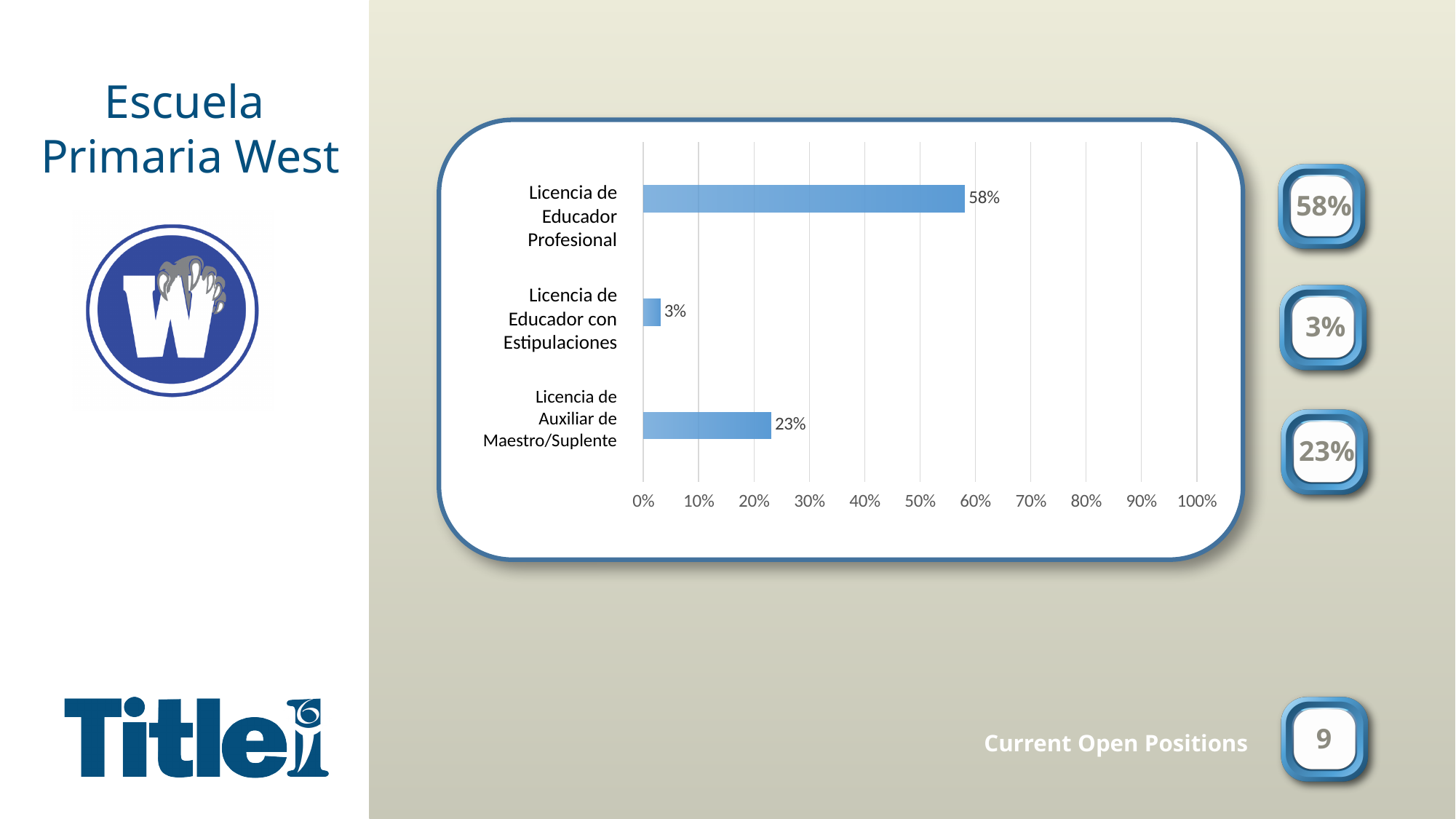
Which category has the highest value? Licencia de Educador Profesional Which is larger, the value for Licencia de Auxiliar de Maestro/Suplente or the value for Licencia de Educador con Estipulaciones? Licencia de Auxiliar de Maestro/Suplente How many categories are shown in the chart? 3 What kind of chart is shown on the slide? bar chart What is the value for Licencia de Auxiliar de Maestro/Suplente? 23% What is the value for Licencia de Educador Profesional? 58% Is the value for Licencia de Educador Profesional greater or less than 50%? greater Which category has the lowest value? Licencia de Educador con Estipulaciones What is the difference between the values for Licencia de Educador Profesional and Licencia de Auxiliar de Maestro/Suplente? 35% What is the value for Licencia de Educador con Estipulaciones? 3% What is the maximum value shown on the horizontal axis? 100% What is the difference between the values for Licencia de Auxiliar de Maestro/Suplente and Licencia de Educador con Estipulaciones? 20%